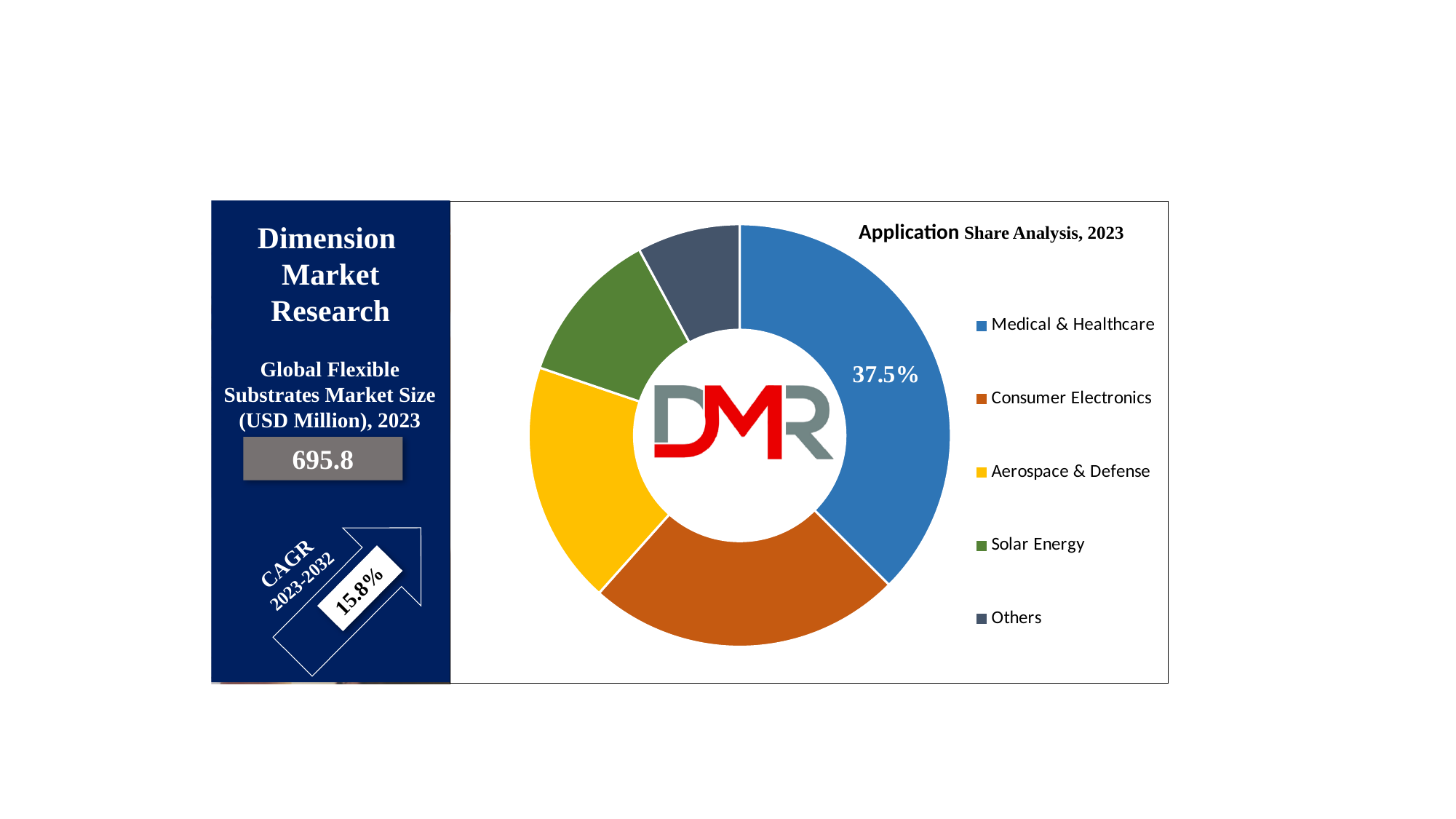
Which has the larger share, Aerospace & Defense or Solar Energy? Aerospace & Defense What colour represents Medical & Healthcare in the chart? blue What is the title of the chart? Application Share Analysis, 2023 Which slice of the chart is labelled with a percentage value? Medical & Healthcare Which has the larger share, Consumer Electronics or Aerospace & Defense? Consumer Electronics How many entries does the chart legend list? 5 Which application has the smallest share in the chart? Others What kind of chart is shown on the slide? doughnut (pie) chart How many application categories are shown in the chart? 5 What share of the chart does Medical & Healthcare hold? 37.5% Which application has the largest share in the chart? Medical & Healthcare Which has the larger share, Solar Energy or Others? Solar Energy